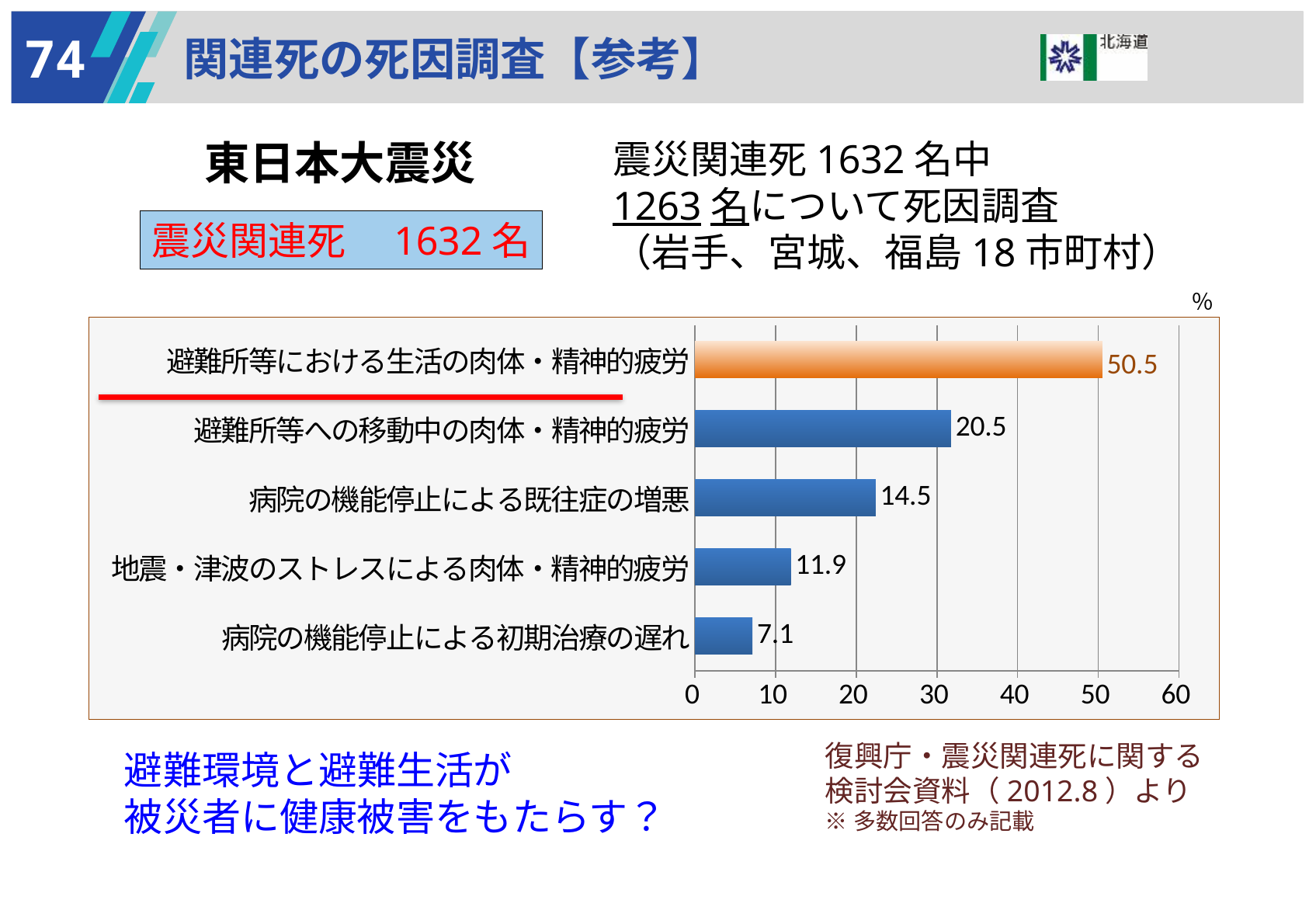
What is the value for 避難所等における生活の肉体・精神的疲労? 50.5 Which category has the lowest value? 病院の機能停止による初期治療の遅れ What is the value for 病院の機能停止による初期治療の遅れ? 7.1 How many categories are shown in the chart? 5 What is the value for 病院の機能停止による既往症の増悪? 14.5 Which is larger: the value for 地震・津波のストレスによる肉体・精神的疲労 or the value for 病院の機能停止による既往症の増悪? 病院の機能停止による既往症の増悪 Which category has the highest value? 避難所等における生活の肉体・精神的疲労 Which bar is coloured orange rather than blue? 避難所等における生活の肉体・精神的疲労 What is the difference between the values for 避難所等における生活の肉体・精神的疲労 and 避難所等への移動中の肉体・精神的疲労? 30 What unit is indicated above the chart's axis? % What kind of chart is shown on the slide? bar chart